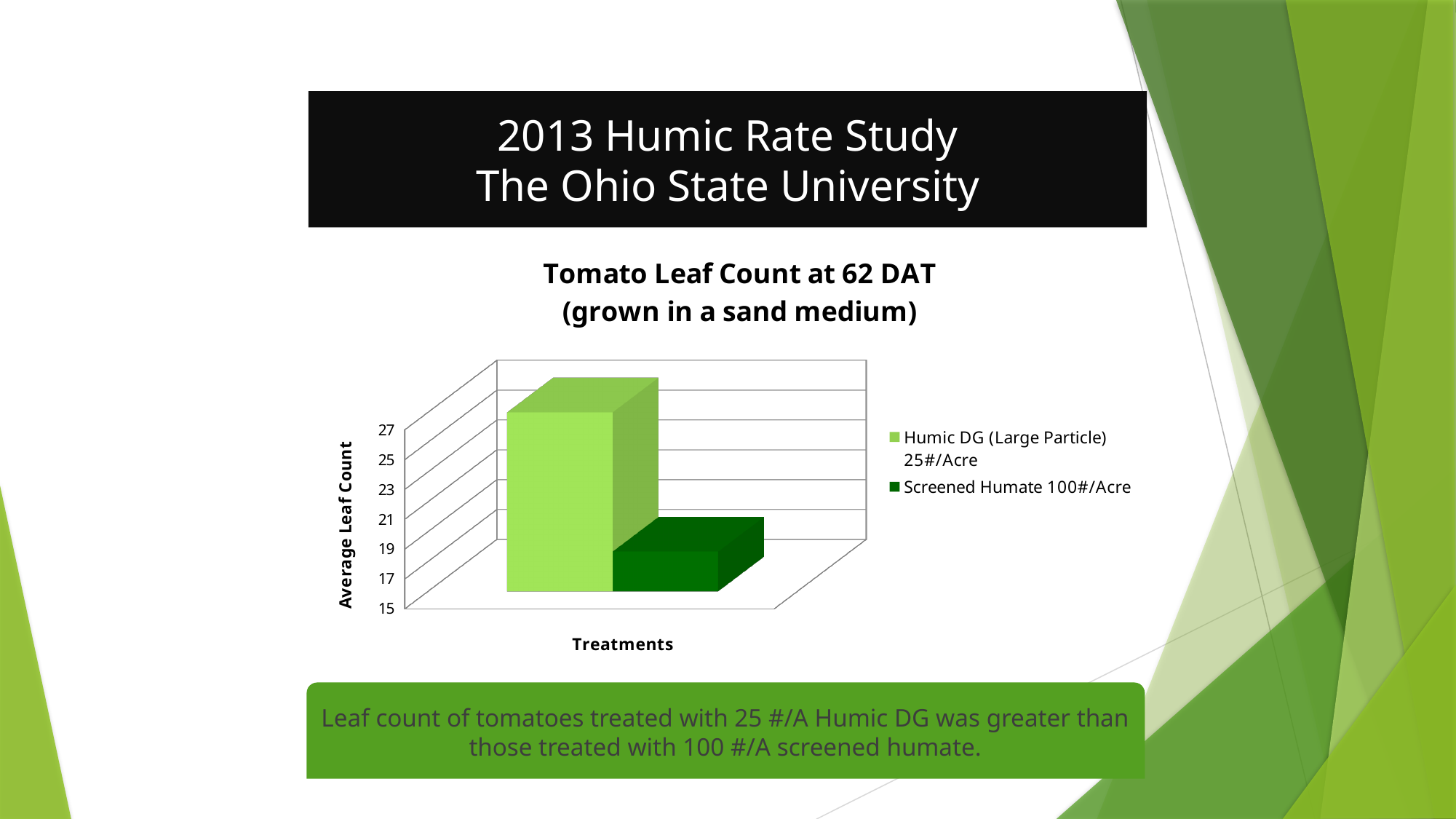
How many series does the chart legend list? 2 Is the average leaf count for Humic DG (Large Particle) 25#/Acre greater or less than 23? greater Which has a larger average leaf count, Humic DG (Large Particle) 25#/Acre or Screened Humate 100#/Acre? Humic DG (Large Particle) 25#/Acre How many bars are plotted in the chart? 2 What is the label of the vertical axis of the chart? Average Leaf Count What kind of chart is shown on the slide? bar chart Is the average leaf count for Screened Humate 100#/Acre greater or less than 15? greater What is the title of the chart? Tomato Leaf Count at 62 DAT (grown in a sand medium) Is the average leaf count for Screened Humate 100#/Acre greater or less than 21? less Which treatment has the lowest average leaf count? Screened Humate 100#/Acre Which treatment has the highest average leaf count? Humic DG (Large Particle) 25#/Acre